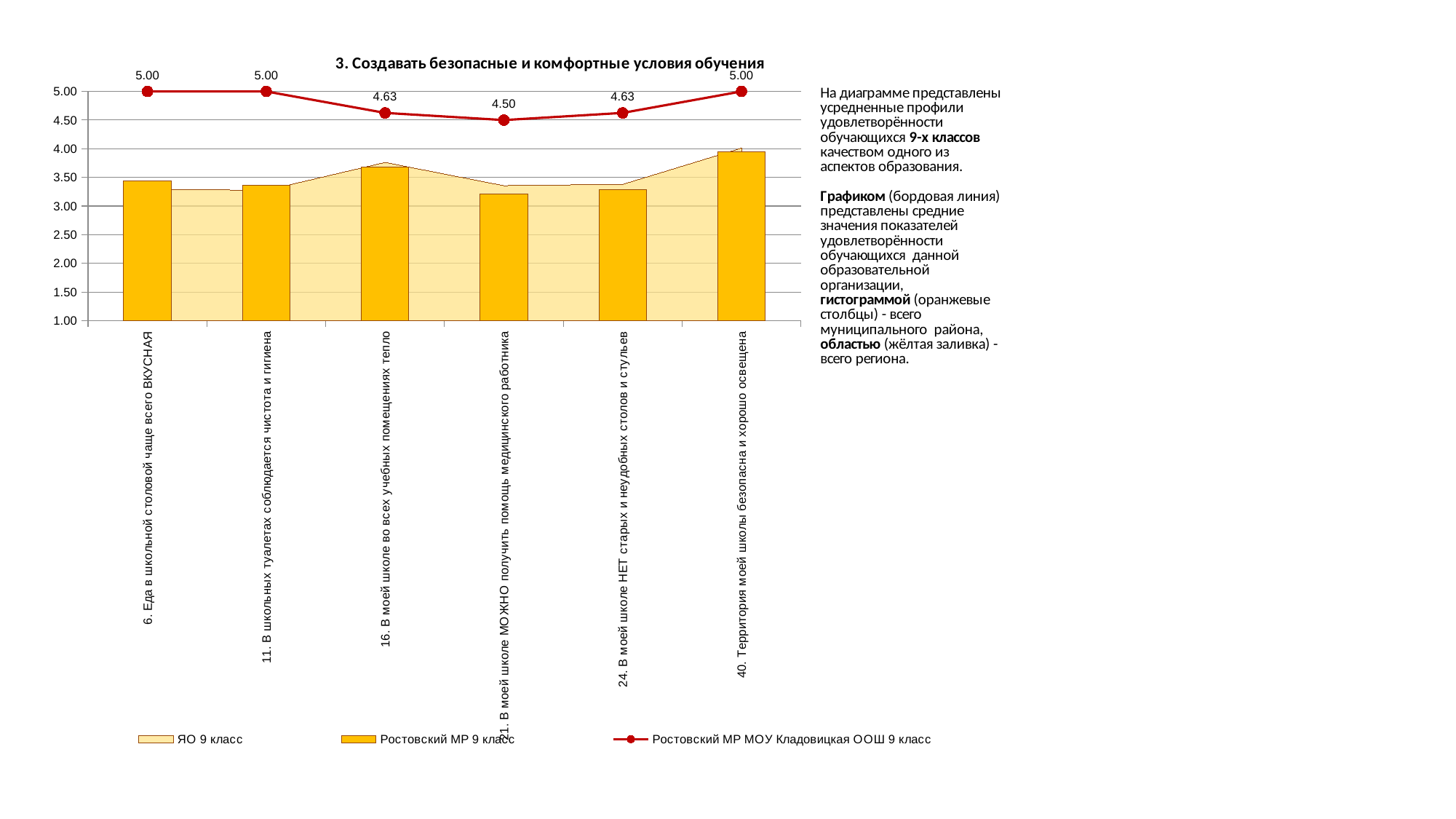
What is the value of the Ростовский МР МОУ Кладовицкая ООШ 9 класс line for category 21 (В моей школе МОЖНО получить помощь медицинского работника)? 4.50 What is the difference between the line values for category 6 and category 21? 0.50 Is the Ростовский МР 9 класс bar for category 21 greater or less than 3.50? less What is the value of the Ростовский МР МОУ Кладовицкая ООШ 9 класс line for category 6 (Еда в школьной столовой чаще всего ВКУСНАЯ)? 5.00 What is the title of the chart? 3. Создавать безопасные и комфортные условия обучения What is the value of the Ростовский МР МОУ Кладовицкая ООШ 9 класс line for category 24 (В моей школе НЕТ старых и неудобных столов и стульев)? 4.63 Which category has the tallest Ростовский МР 9 класс bar? 40. Территория моей школы безопасна и хорошо освещена Is the Ростовский МР 9 класс bar for category 40 (Территория моей школы безопасна и хорошо освещена) greater or less than 3.50? greater For which category is the Ростовский МР МОУ Кладовицкая ООШ 9 класс line lowest? 21. В моей школе МОЖНО получить помощь медицинского работника Which Ростовский МР 9 класс bar is taller: category 16 or category 24? 16. В моей школе во всех учебных помещениях тепло How many series does the legend list? 3 How many categories are shown on the x axis? 6